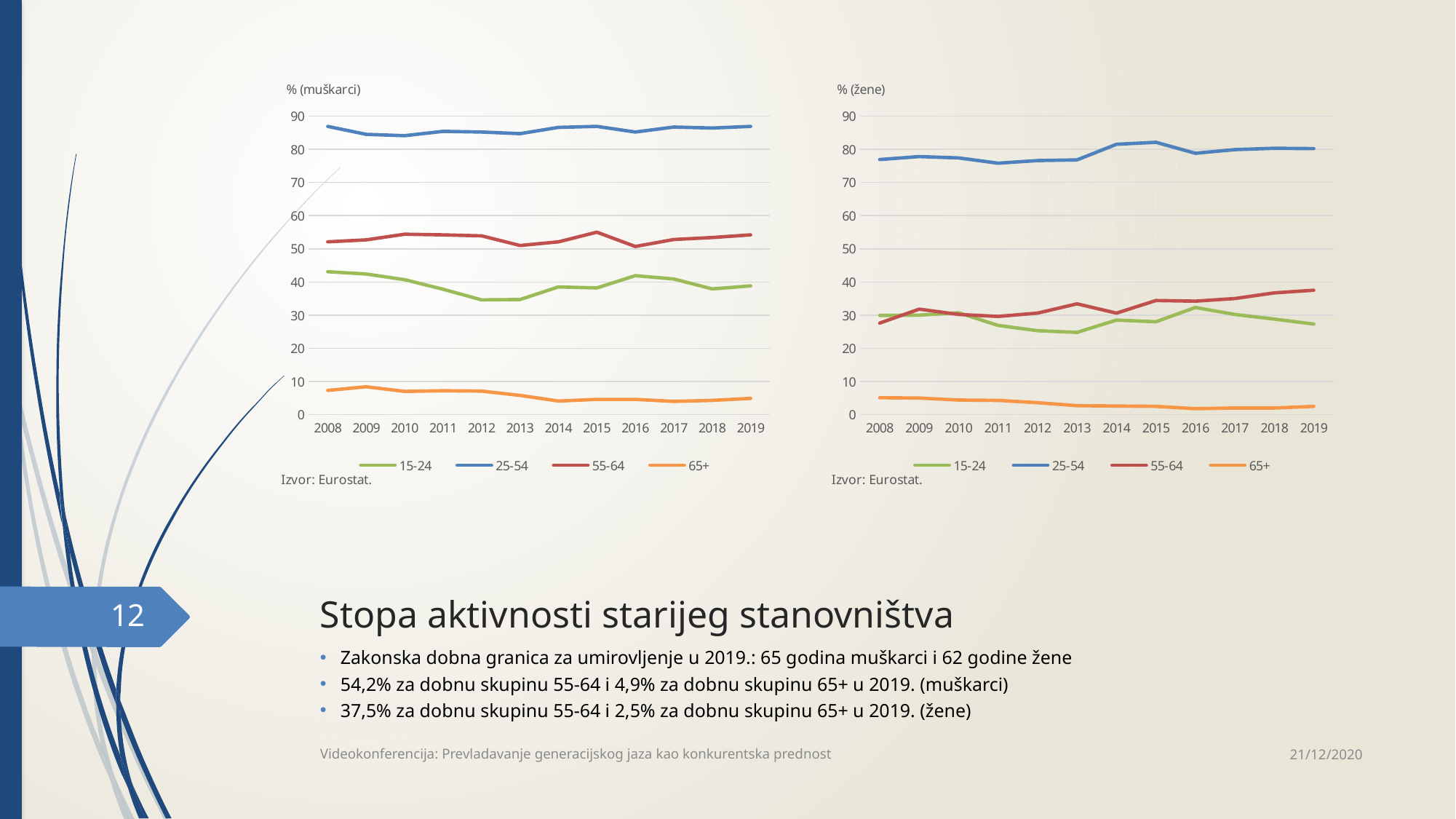
In the chart titled "% (žene)", which age group has the lowest values across all years? 65+ How many series does the legend of the chart titled "% (žene)" list? 4 In the chart titled "% (muškarci)", what is the value for the 55-64 age group in 2019? 54,2% How many years are shown on the x axis of the chart titled "% (muškarci)"? 12 In the chart titled "% (žene)", what is the value for the 55-64 age group in 2019? 37,5% In the chart titled "% (muškarci)", which age group has the highest values across all years? 25-54 In the chart titled "% (žene)", what is the value for the 65+ age group in 2019? 2,5% In the chart titled "% (muškarci)", what is the difference between the 55-64 and 65+ values in 2019? 49,3 percentage points In the chart titled "% (muškarci)", is the value for the 25-54 group in 2019 greater or less than 80? greater In the chart titled "% (žene)", does the 55-64 line rise or fall from 2008 to 2019? rise In the chart titled "% (žene)", which is larger in 2019: the value for 55-64 or the value for 15-24? 55-64 In the chart titled "% (žene)", is the value for the 25-54 group in 2008 greater or less than 80? less